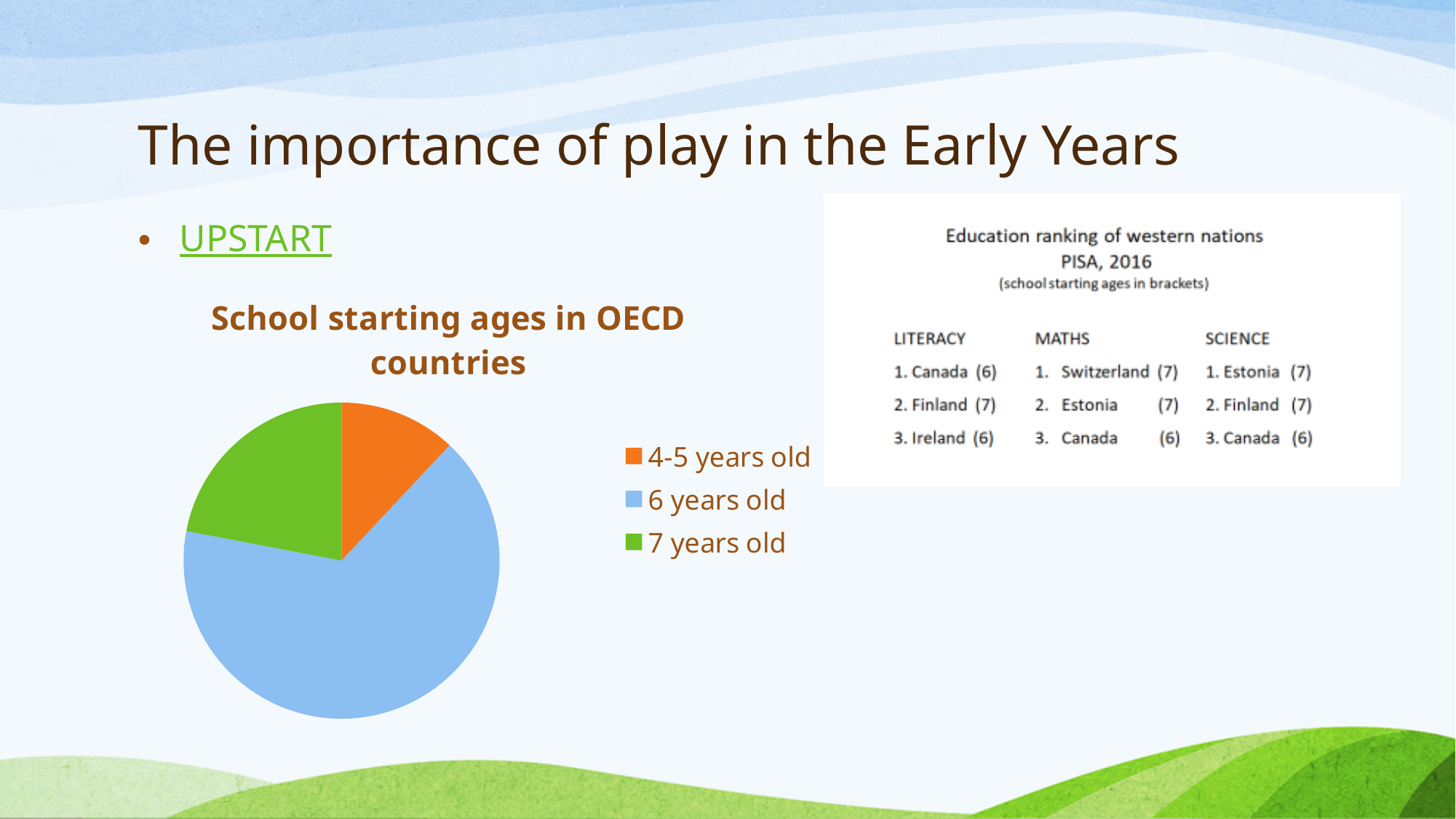
In the "School starting ages in OECD countries" pie chart, which slice is larger: 6 years old or 7 years old? 6 years old What is the title of the pie chart on the slide? School starting ages in OECD countries What kind of chart is "School starting ages in OECD countries"? pie chart In the "School starting ages in OECD countries" pie chart, which slice is larger: 4-5 years old or 7 years old? 7 years old How many entries does the legend of the "School starting ages in OECD countries" chart list? 3 What colour is the "6 years old" slice in the "School starting ages in OECD countries" pie chart? blue How many slices does the "School starting ages in OECD countries" pie chart have? 3 Which category has the largest slice in the "School starting ages in OECD countries" pie chart? 6 years old Which category has the smallest slice in the "School starting ages in OECD countries" pie chart? 4-5 years old